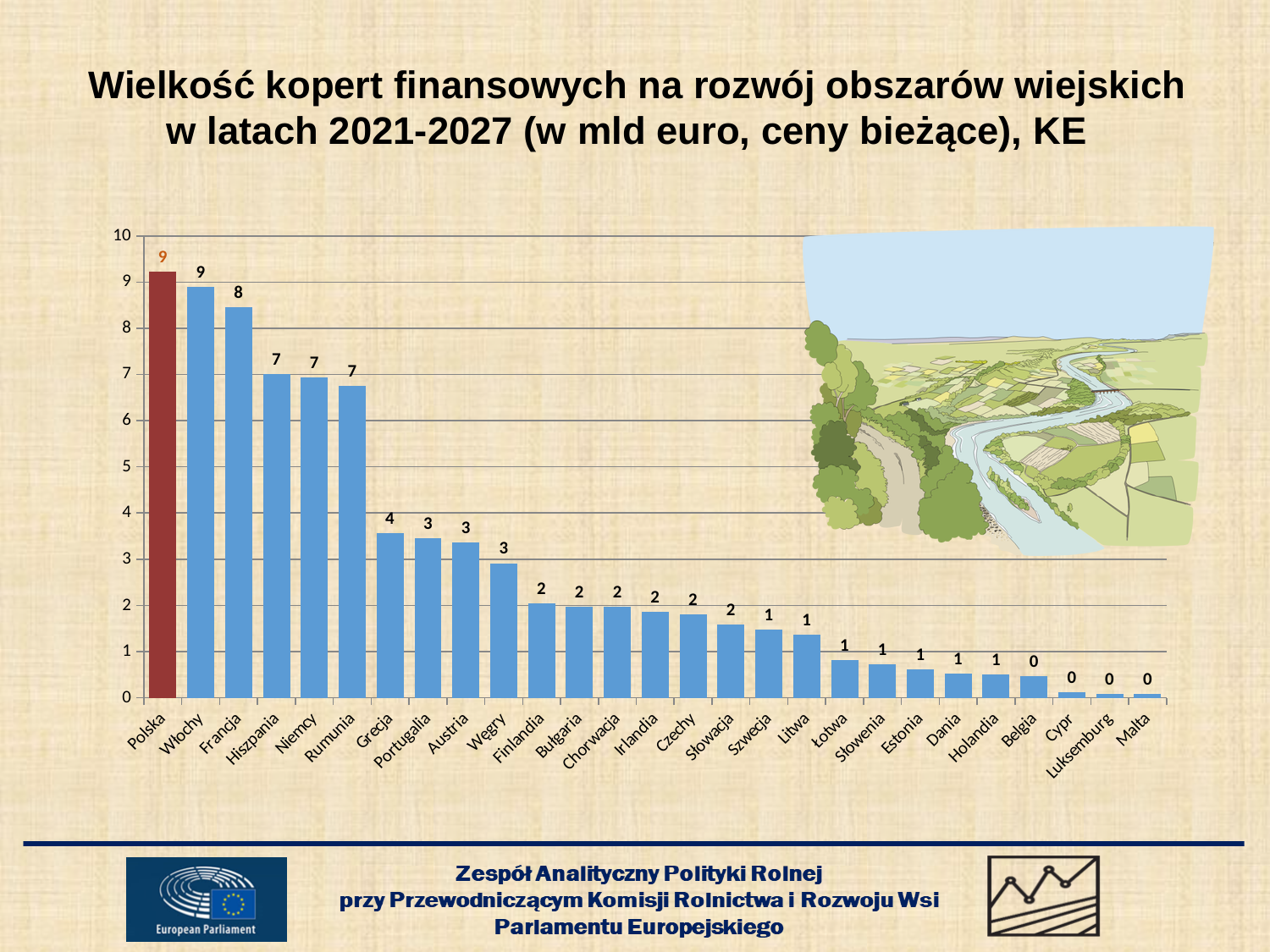
What is the data label shown for Polska? 9 How many countries are shown on the x axis of the chart? 27 Do the values rise or fall moving from left to right along the x axis? fall Is the value for Rumunia greater or less than 6? greater Which country has the highest value in the chart? Polska What is the data label shown for Malta? 0 Which bar is coloured differently (dark red) from the other bars? Polska Is the value for Grecja greater or less than 3? greater What is the data label shown for Francja? 8 Which is larger, the value for Francja or the value for Hiszpania? Francja What type of chart is shown on the slide? bar chart What is the data label shown for Grecja? 4